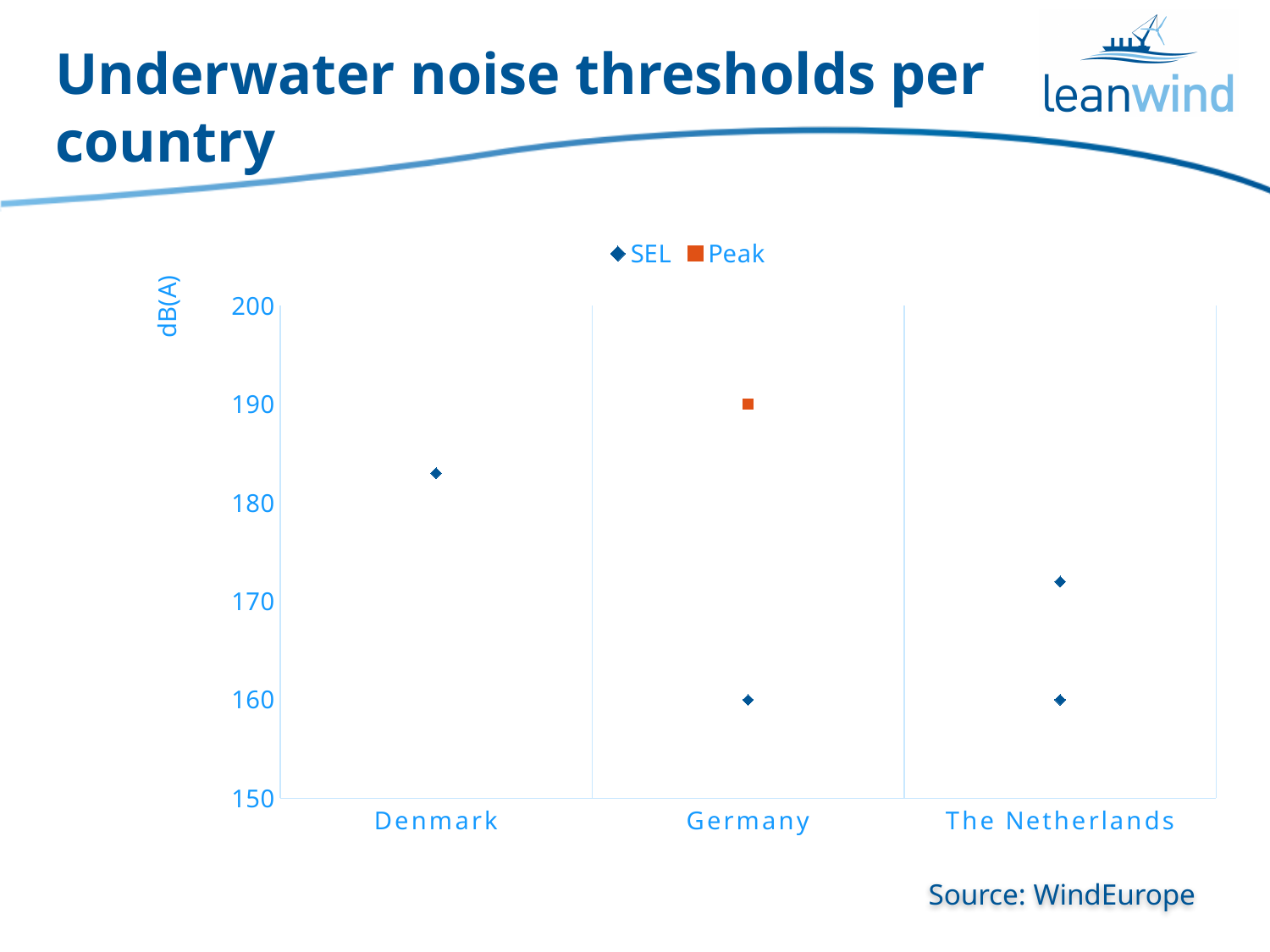
What is the SEL value for Germany? 160 Which country has the highest SEL value? Denmark How many countries are shown on the x axis? 3 Is the SEL value for Denmark greater or less than 180? greater Is the higher SEL value for The Netherlands greater or less than 180? less What is the difference between the Peak and SEL values for Germany? 30 How many series does the legend list? 2 What is the Peak value for Germany? 190 What unit is shown on the y axis label? dB(A) For Germany, which is larger, the Peak value or the SEL value? Peak What are the two series named in the legend? SEL and Peak